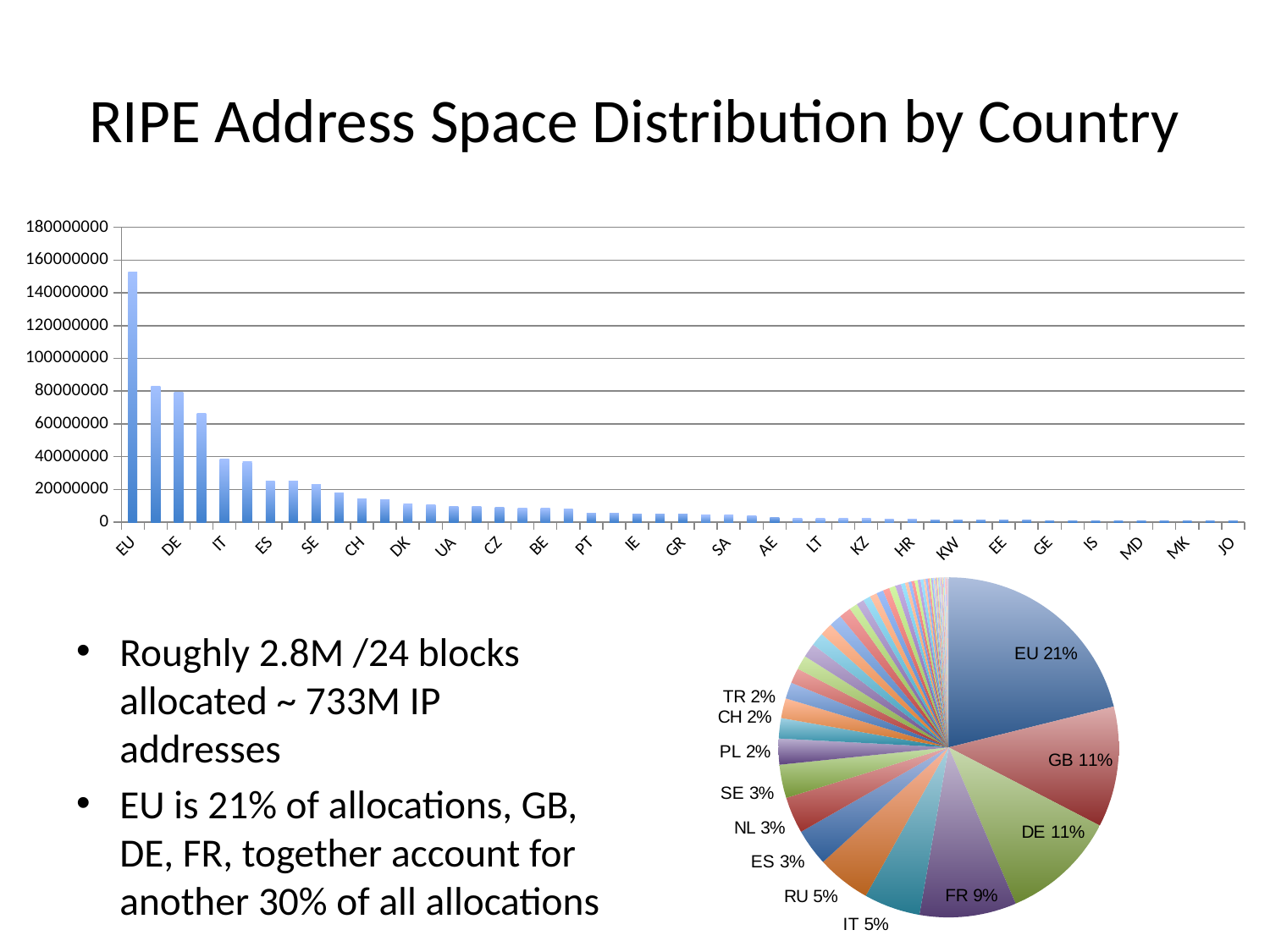
What kind of chart is the chart at the bottom right of the slide? pie chart In the top bar chart, do the values rise or fall from left to right along the x axis? fall In the pie chart, what is the difference between the share for EU and the share for GB? 10% In the top bar chart, is the value for ES greater or less than 20000000? greater In the pie chart, what share does EU have? 21% In the top bar chart, which country has the highest value? EU In the pie chart, which labelled slice is the largest? EU What kind of chart is the top chart on the slide? bar chart In the pie chart, which is larger, the share for GB or the share for FR? GB In the top bar chart, is the value for EU greater or less than 140000000? greater In the pie chart, what share does FR have? 9% In the top bar chart, is the value for CH greater or less than 20000000? less